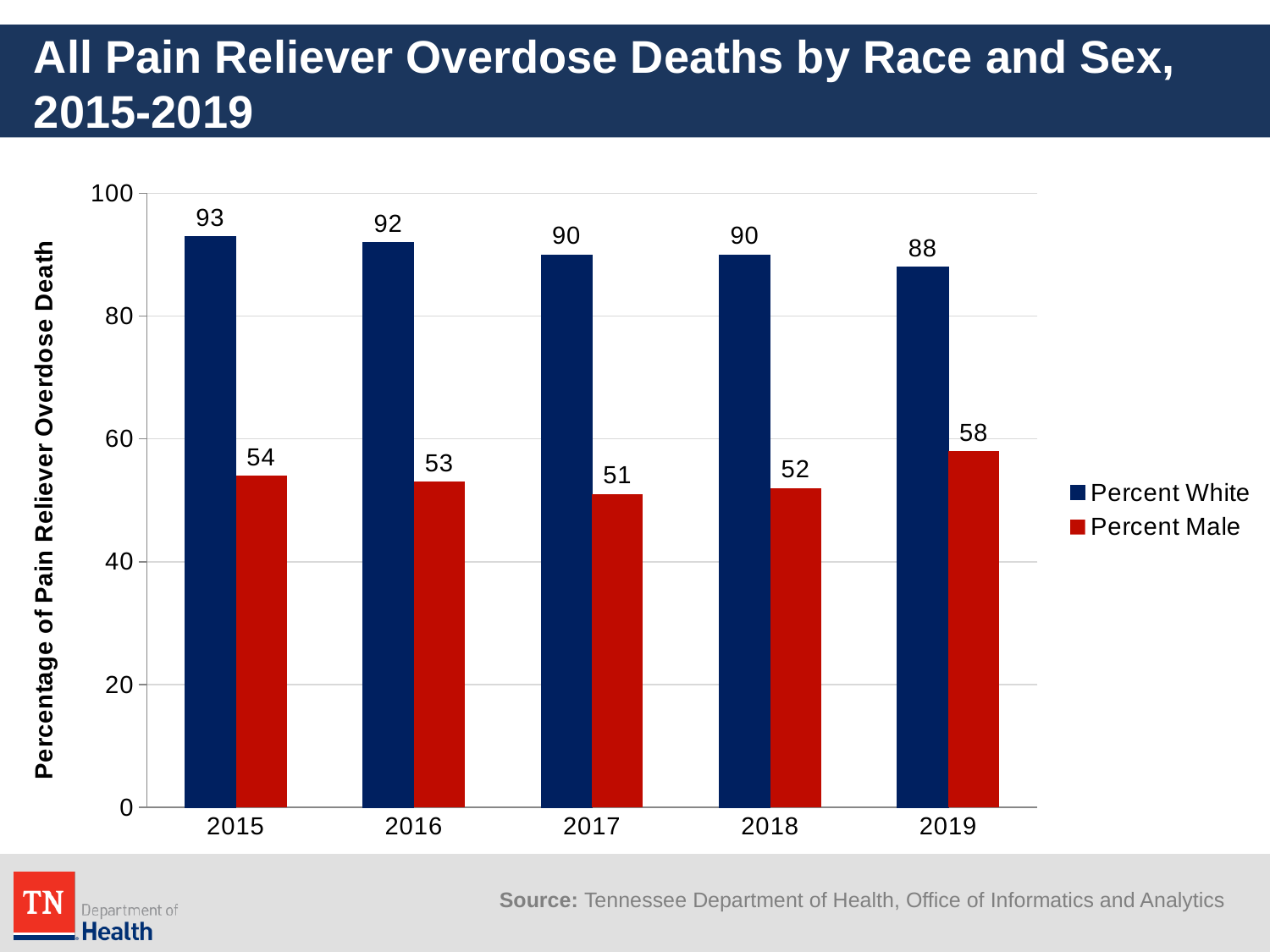
What is the Percent Male value for 2017? 51 How many years are shown on the x axis? 5 What is the Percent White value for 2015? 93 Which year has the highest Percent Male value? 2019 What is the Percent Male value for 2019? 58 Which year has the lowest Percent White value? 2019 Is the Percent White value for 2017 greater or less than 80? greater What is the difference between the Percent White and Percent Male values in 2018? 38 How many series does the legend list? 2 Does the Percent White value rise or fall from 2015 to 2019? Fall What kind of chart is shown on the slide? Bar chart Which is larger, the Percent Male value for 2015 or for 2016? 2015